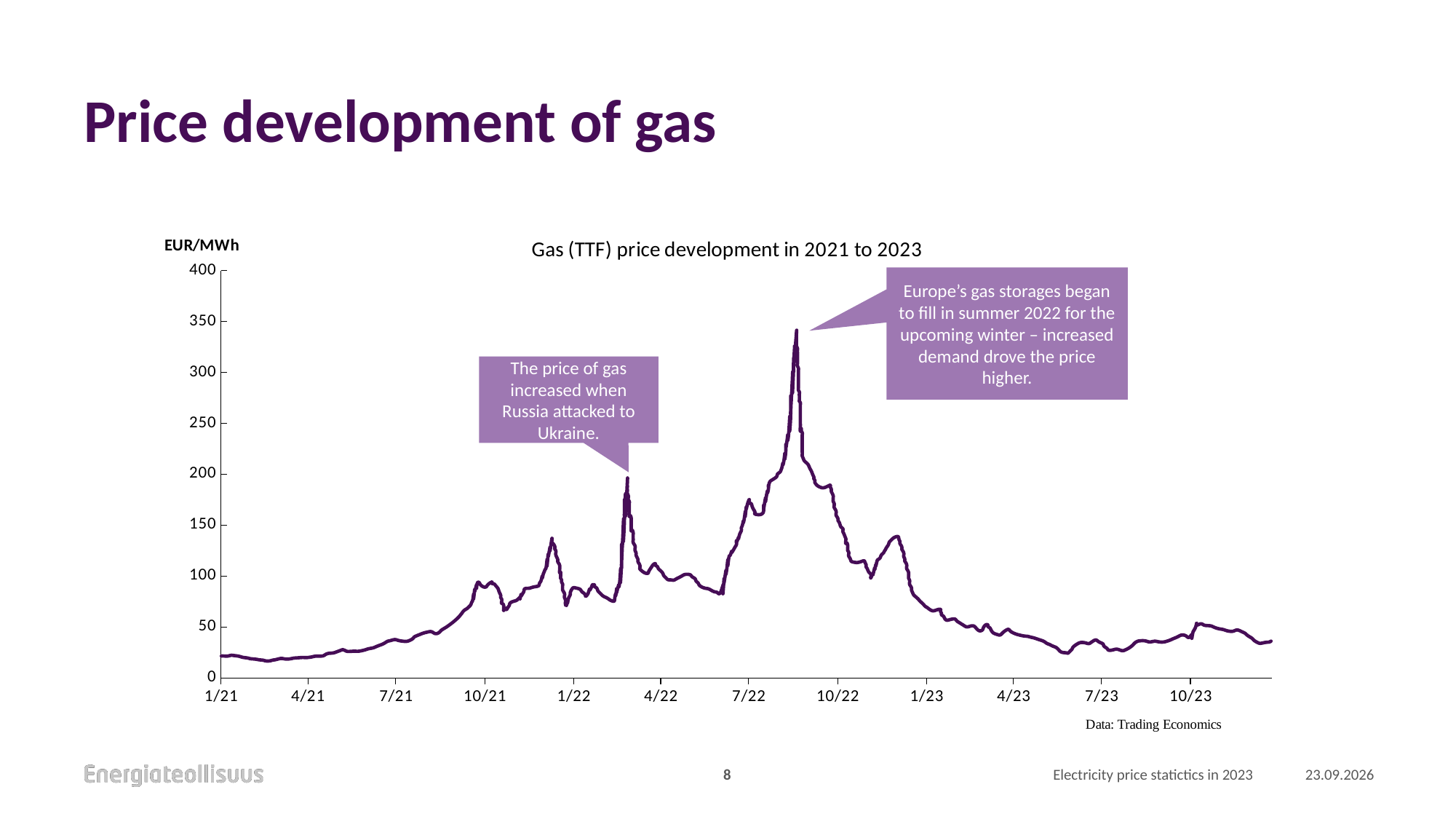
Is the highest peak of the gas price greater or less than 300 EUR/MWh? greater What unit is shown on the y axis of the chart? EUR/MWh Does the gas price generally rise or fall from 1/21 to 7/22? rise Is the gas price at 1/23 greater or less than 100 EUR/MWh? less What is the title of the chart? Gas (TTF) price development in 2021 to 2023 Does the gas price generally rise or fall from 10/22 to 7/23? fall Between which two x-axis labels does the gas price reach its highest point? between 7/22 and 10/22 Is the gas price at 1/21 greater or less than 50 EUR/MWh? less What kind of chart is shown on the slide? line chart How many labelled tick marks are on the x axis of the chart? 12